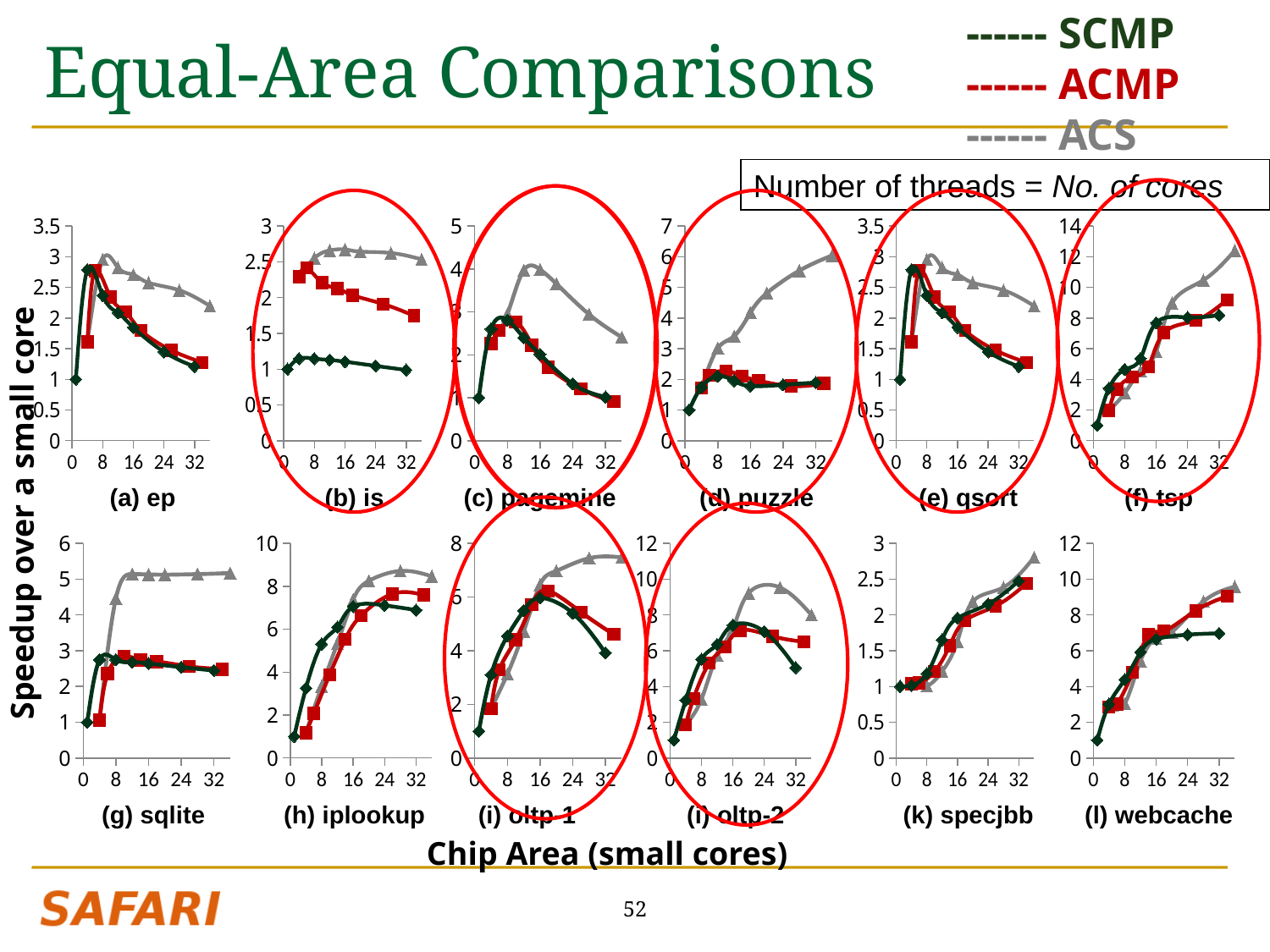
How many series does the legend at the top right list? 3 What is the x-axis label shared by the charts? Chip Area (small cores) In chart '(l) webcache', at chip area 32, which series is higher, ACMP or SCMP? ACMP In chart '(d) puzzle', at chip area 32, which series is higher, ACS or ACMP? ACS What is the y-axis label shared by the charts? Speedup over a small core How many charts (benchmarks) are shown on the slide? 12 In chart '(c) pagemine', which series reaches the highest peak? ACS In chart '(b) is', is the SCMP value at chip area 32 greater or less than 1.5? less In chart '(k) specjbb', do the values rise or fall as chip area increases? rise What kind of chart is '(a) ep'? line chart In chart '(g) sqlite', is the ACS value at chip area 32 greater or less than 4? greater In chart '(f) tsp', is the ACS value at chip area 32 greater or less than 10? greater